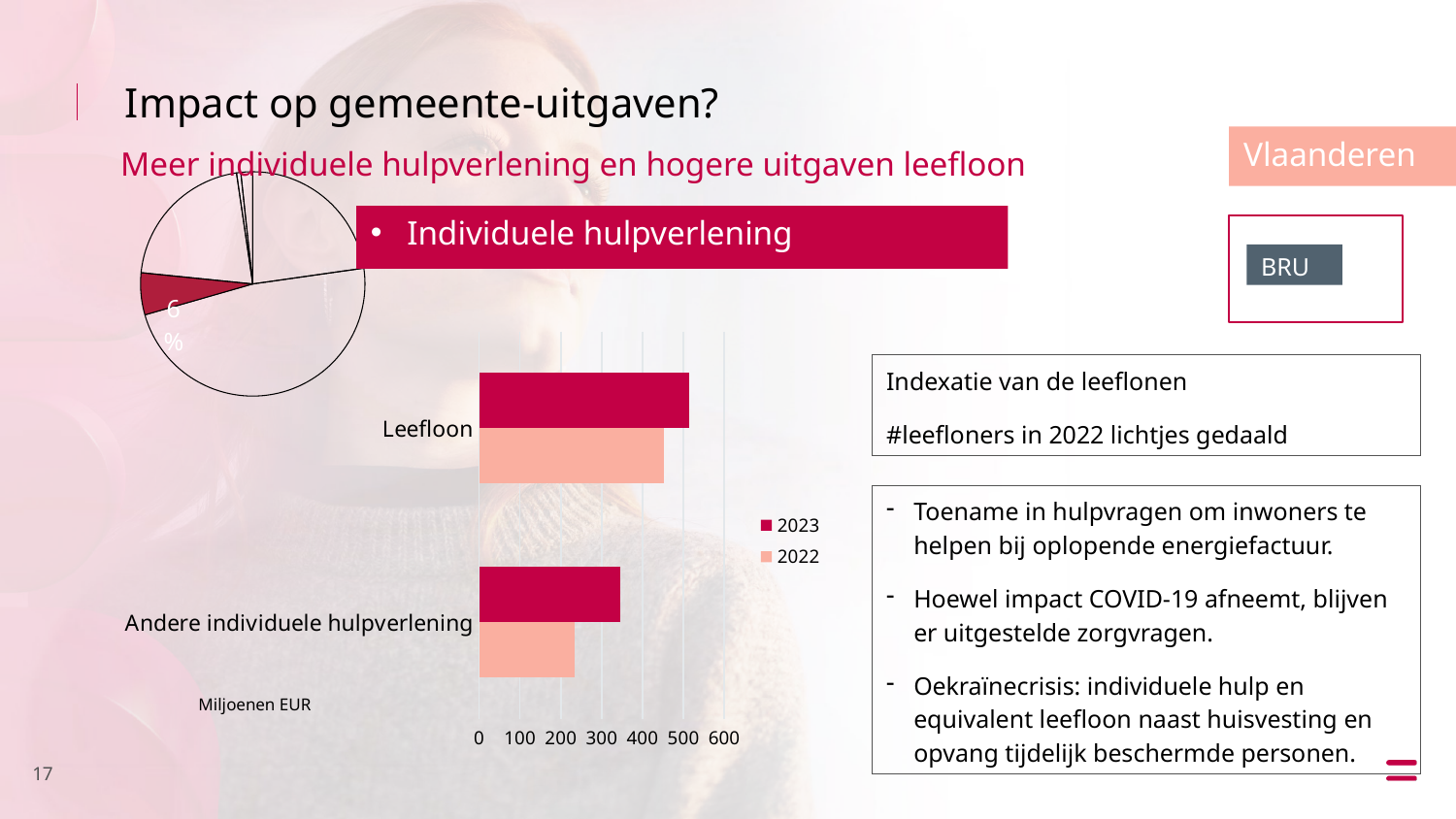
How many categories does the bar chart show? 2 In the bar chart, which year has the larger value for Andere individuele hulpverlening, 2023 or 2022? 2023 In the bar chart, is the 2023 value for Andere individuele hulpverlening greater or less than 400? less What kind of chart is used to show Leefloon and Andere individuele hulpverlening? bar chart In the bar chart, is the 2022 value for Leefloon greater or less than 400? greater In the bar chart, which year has the larger value for Leefloon, 2023 or 2022? 2023 Which years are listed in the legend of the bar chart? 2023 and 2022 In the bar chart, is the 2023 value for Leefloon greater or less than 400? greater What unit is indicated for the values in the bar chart? Miljoenen EUR Which bar in the bar chart is the longest? Leefloon, 2023 How many series does the legend of the bar chart list? 2